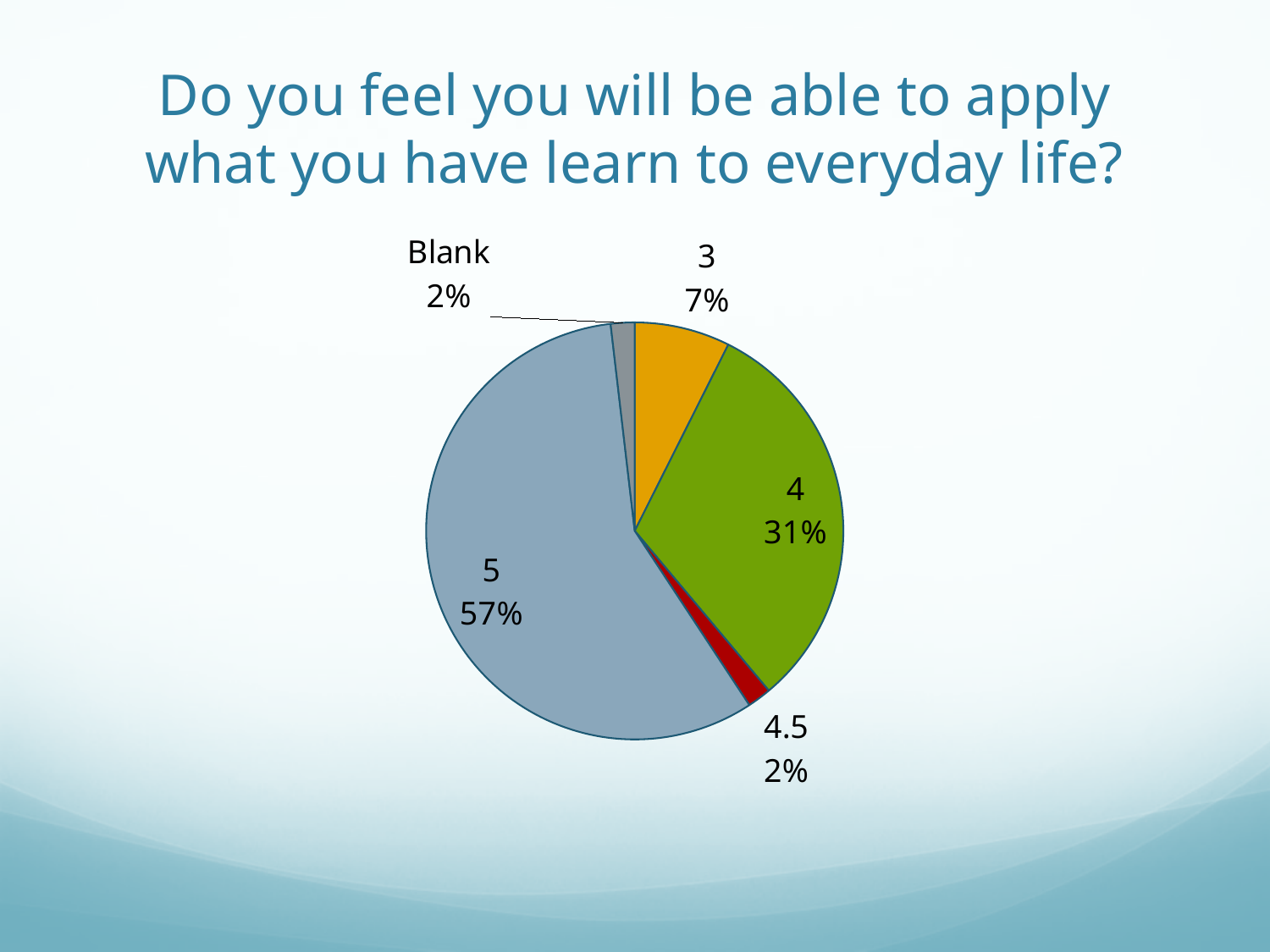
What is the title of the chart on the slide? Do you feel you will be able to apply what you have learn to everyday life? What kind of chart is shown on the slide? pie chart What is the difference in percentage points between the "5" slice and the "4" slice? 26 What colour is the "4" slice in the pie chart? green What share of the pie does the "5" slice represent? 57% How many slices does the pie chart have? 5 Which slice is larger, "4" or "3"? 4 What share of the pie does the "Blank" slice represent? 2% What share of the pie does the "3" slice represent? 7% Which slice is the largest in the pie chart? 5